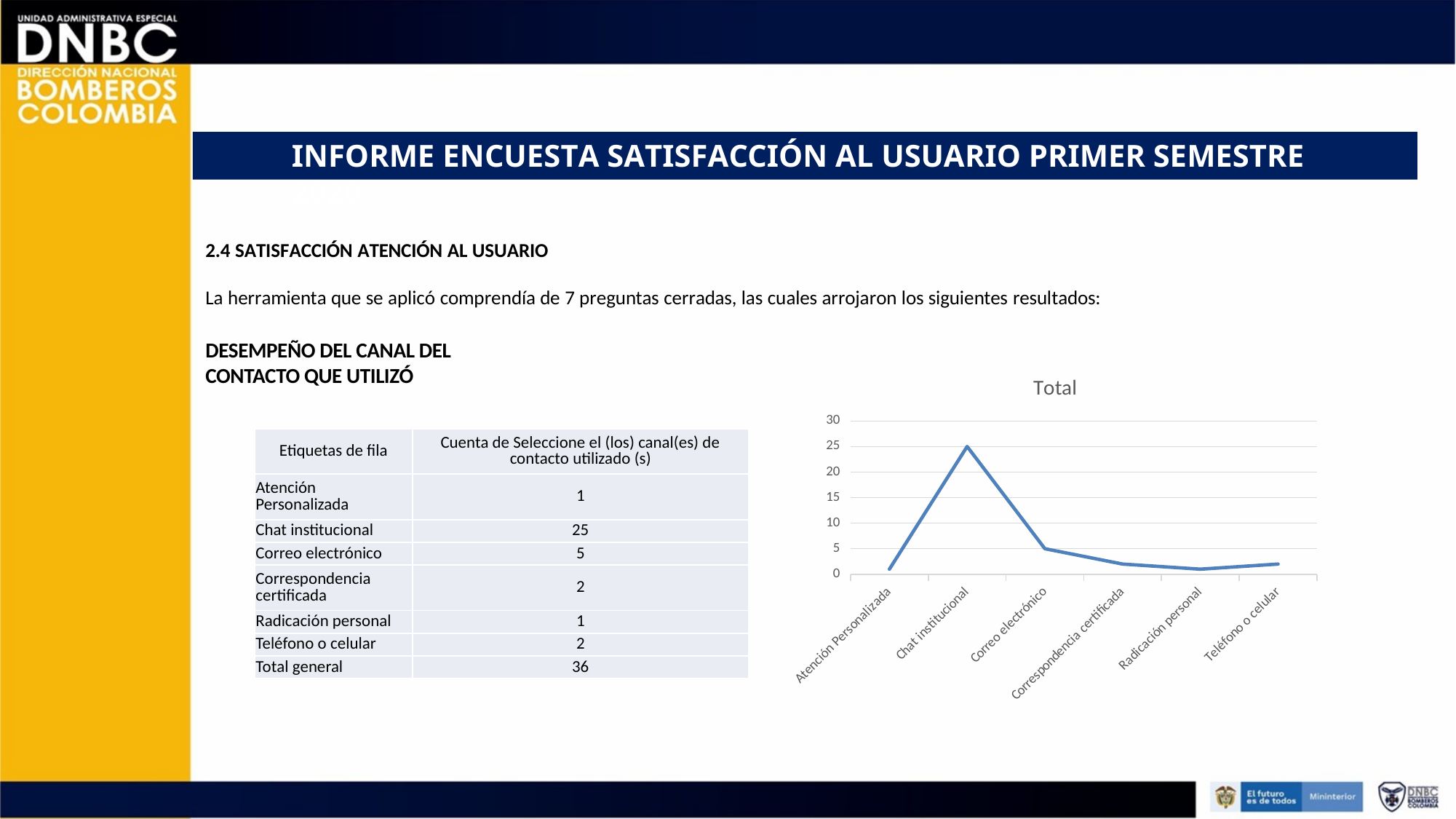
What kind of chart is shown on the slide? line chart What is the value for Correo electrónico? 5 What is the title of the chart? Total What is the difference between the values for Chat institucional and Correo electrónico? 20 How many categories are plotted along the x axis of the chart? 6 Which category has the highest value in the chart? Chat institucional What is the value for Correspondencia certificada? 2 What is the value for Chat institucional? 25 Is the value for Radicación personal greater or less than 5? less Does the line rise or fall from Chat institucional to Radicación personal? fall Is the value for Chat institucional greater or less than 20? greater Which is larger, the value for Chat institucional or the value for Correo electrónico? Chat institucional